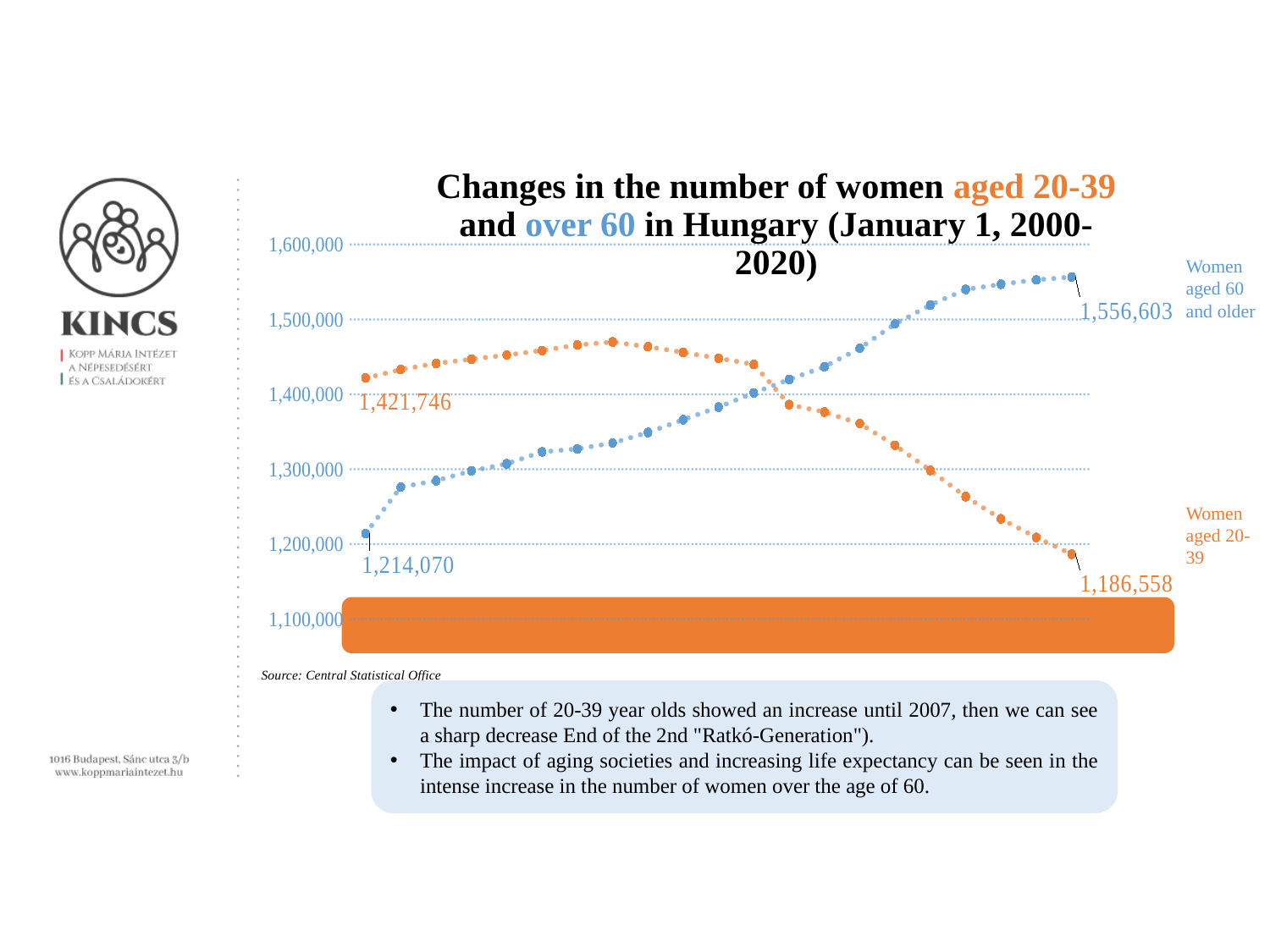
By how much did the number of women aged 20-39 decrease between the first and last labelled values? 235,188 By how much did the number of women aged 60 and older increase between the first and last labelled values? 342,533 What is the number of women aged 20-39 at the start of the series (2000)? 1,421,746 At the end of the series (2020), which group is larger: women aged 60 and older or women aged 20-39? Women aged 60 and older What is the number of women aged 20-39 at the end of the series (2020)? 1,186,558 Does the number of women aged 60 and older rise or fall over the period shown? rise What kind of chart is shown on the slide? line chart What is the number of women aged 60 and older at the start of the series (2000)? 1,214,070 How many series are plotted on the chart? 2 Is the highest value of the women aged 20-39 series greater or less than 1,500,000? less At the start of the series (2000), which group is larger: women aged 20-39 or women aged 60 and older? Women aged 20-39 What is the number of women aged 60 and older at the end of the series (2020)? 1,556,603